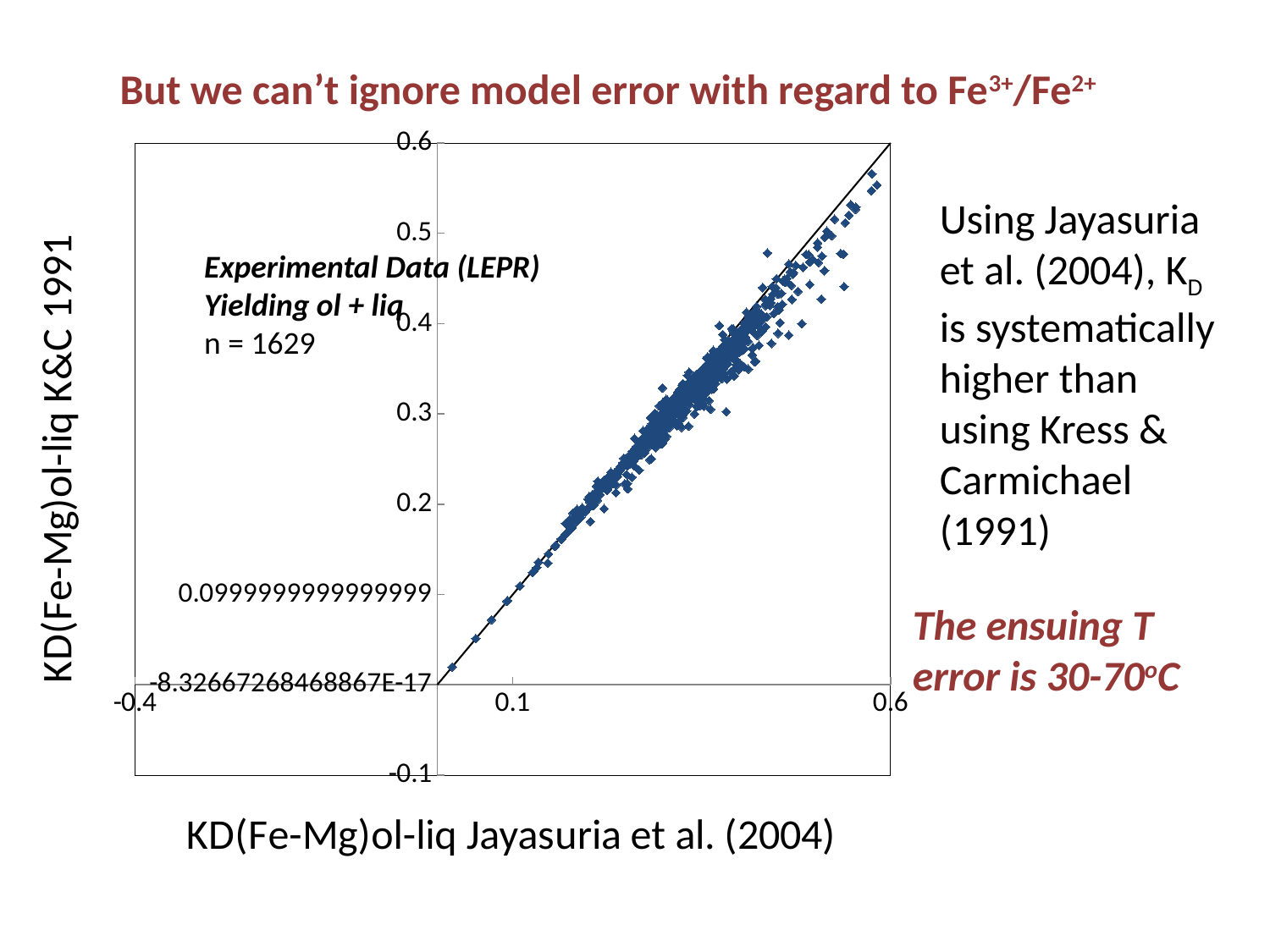
Do the plotted values rise or fall as the x-axis value increases? rise What is the highest tick value shown on the y axis? 0.6 What is the label of the x axis? KD(Fe-Mg)ol-liq Jayasuria et al. (2004) What kind of chart is shown on the slide? scatter chart How many experimental data points are plotted, according to the annotation on the chart? 1629 What is the lowest tick value shown on the y axis? -0.1 What is the lowest tick value shown on the x axis? -0.4 What is the label of the y axis? KD(Fe-Mg)ol-liq K&C 1991